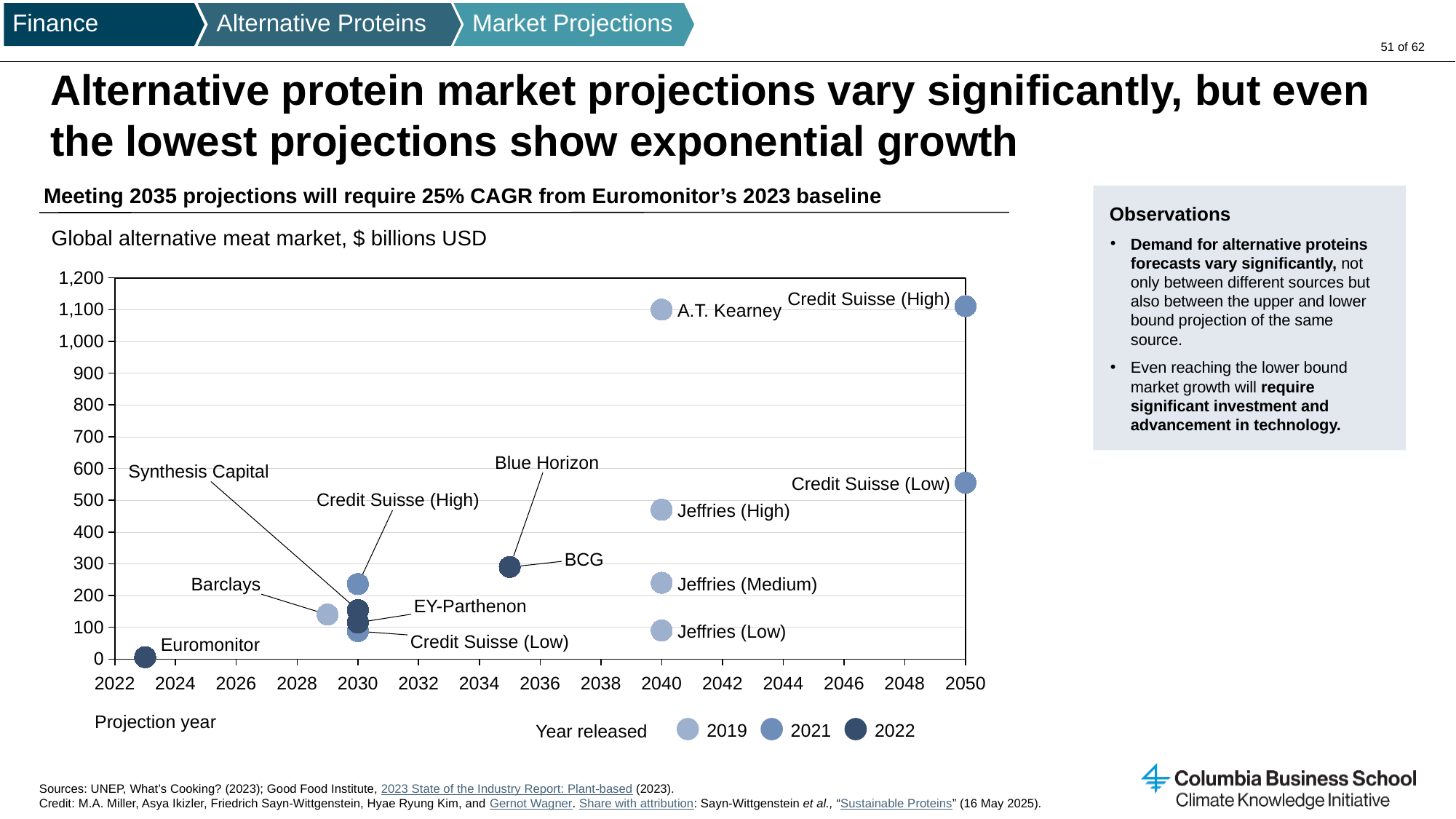
How many 'Year released' categories does the legend list? 3 Which source has the lowest value on the chart? Euromonitor Which has the larger value, Jeffries (Medium) or BCG? BCG How many points are plotted at projection year 2040? 4 What is the label of the x axis? Projection year Is the value for Credit Suisse (Low) in 2050 greater or less than 500? greater What kind of chart is shown on the slide? Scatter chart Is the value for Jeffries (High) greater or less than 400? greater Is the value for A.T. Kearney greater or less than 1,000? greater Which projection year does the A.T. Kearney point fall on? 2040 Which projection year do the Credit Suisse (High) and Credit Suisse (Low) points at the far right fall on? 2050